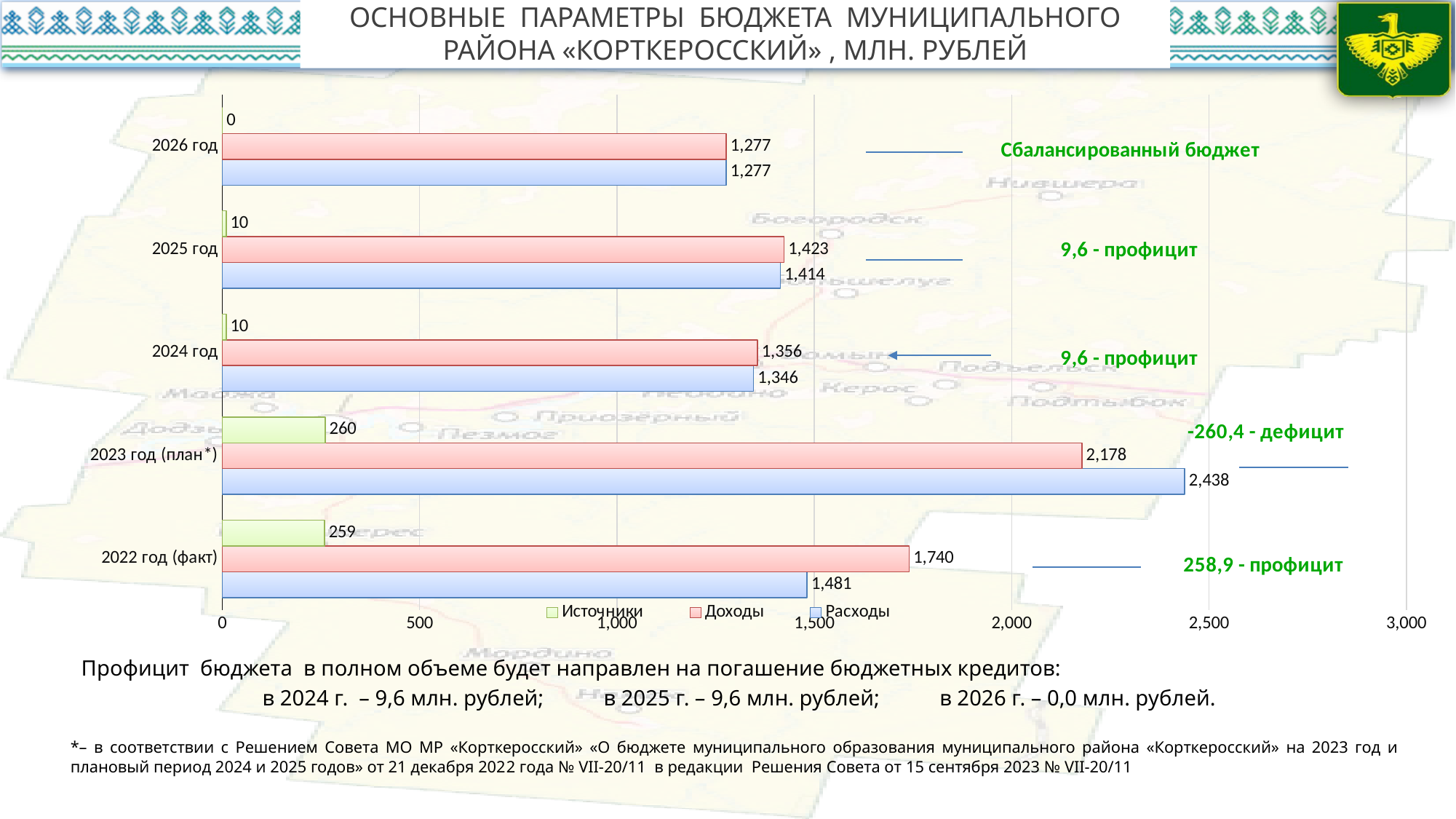
What kind of chart is shown on the slide? Bar chart How many categories (years) are shown on the chart? 5 Which series is shown in red on the chart? Доходы What is the value of Расходы for 2022 год (факт)? 1,481 What is the difference between Расходы and Доходы for 2023 год (план*)? 260 What is the value of Доходы for 2023 год (план*)? 2,178 What is the value of Источники for 2024 год? 10 What is the value of Источники for 2026 год? 0 Which category has the highest Расходы value? 2023 год (план*) How many series does the legend list? 3 Which is larger for 2022 год (факт): Доходы or Расходы? Доходы Which category has the lowest Доходы value? 2026 год